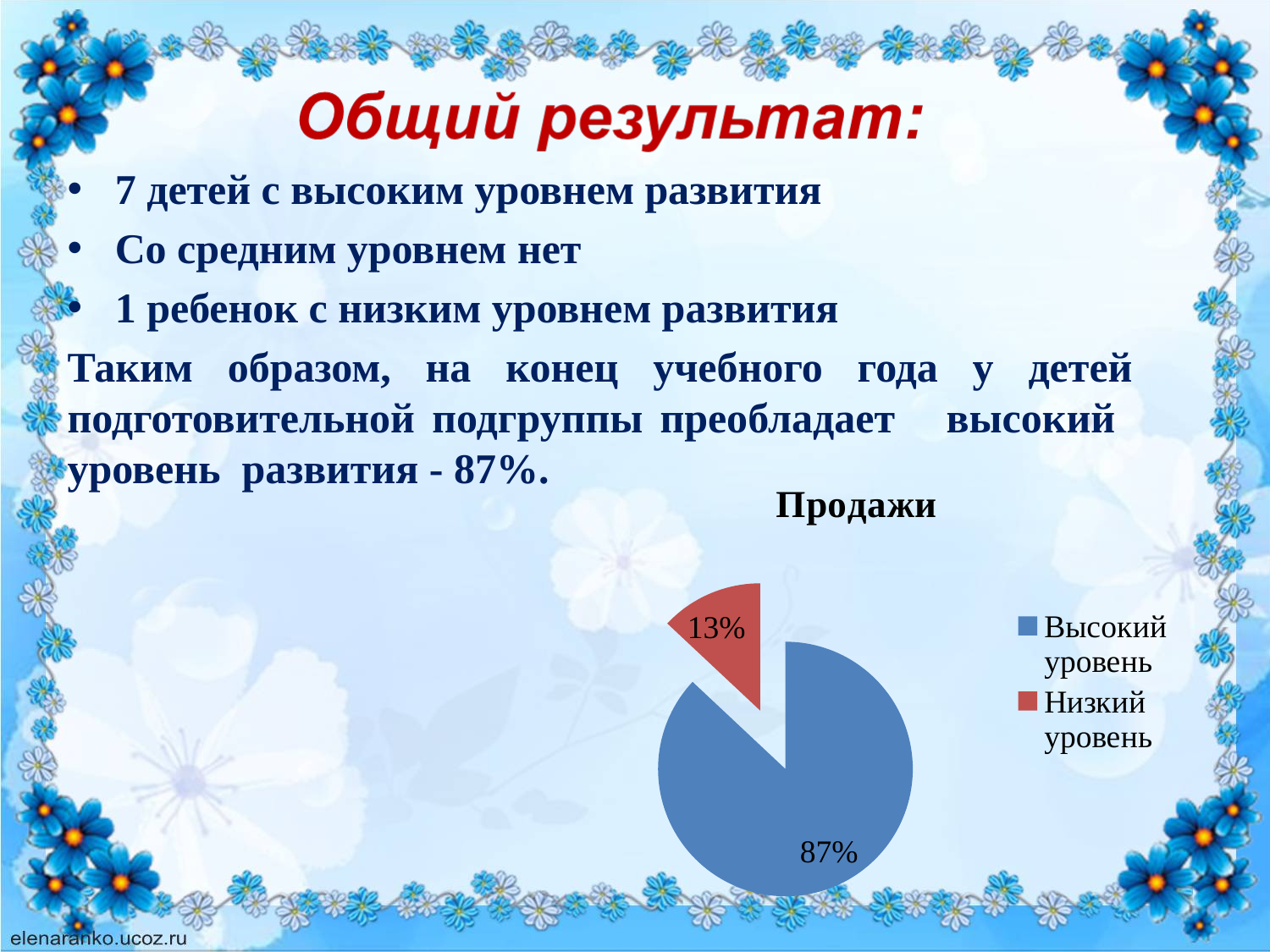
Which slice of the pie is the smallest? Низкий уровень How many entries does the legend list? 2 Which is larger, the "Высокий уровень" slice or the "Низкий уровень" slice? Высокий уровень What is the title of the chart? Продажи How many slices does the pie chart have? 2 What colour is the "Низкий уровень" slice? red Which slice of the pie is the largest? Высокий уровень What kind of chart is shown on the slide? pie chart What share of the pie does "Низкий уровень" take? 13% What is the difference in percentage points between the "Высокий уровень" and "Низкий уровень" slices? 74 What share of the pie does "Высокий уровень" take? 87%